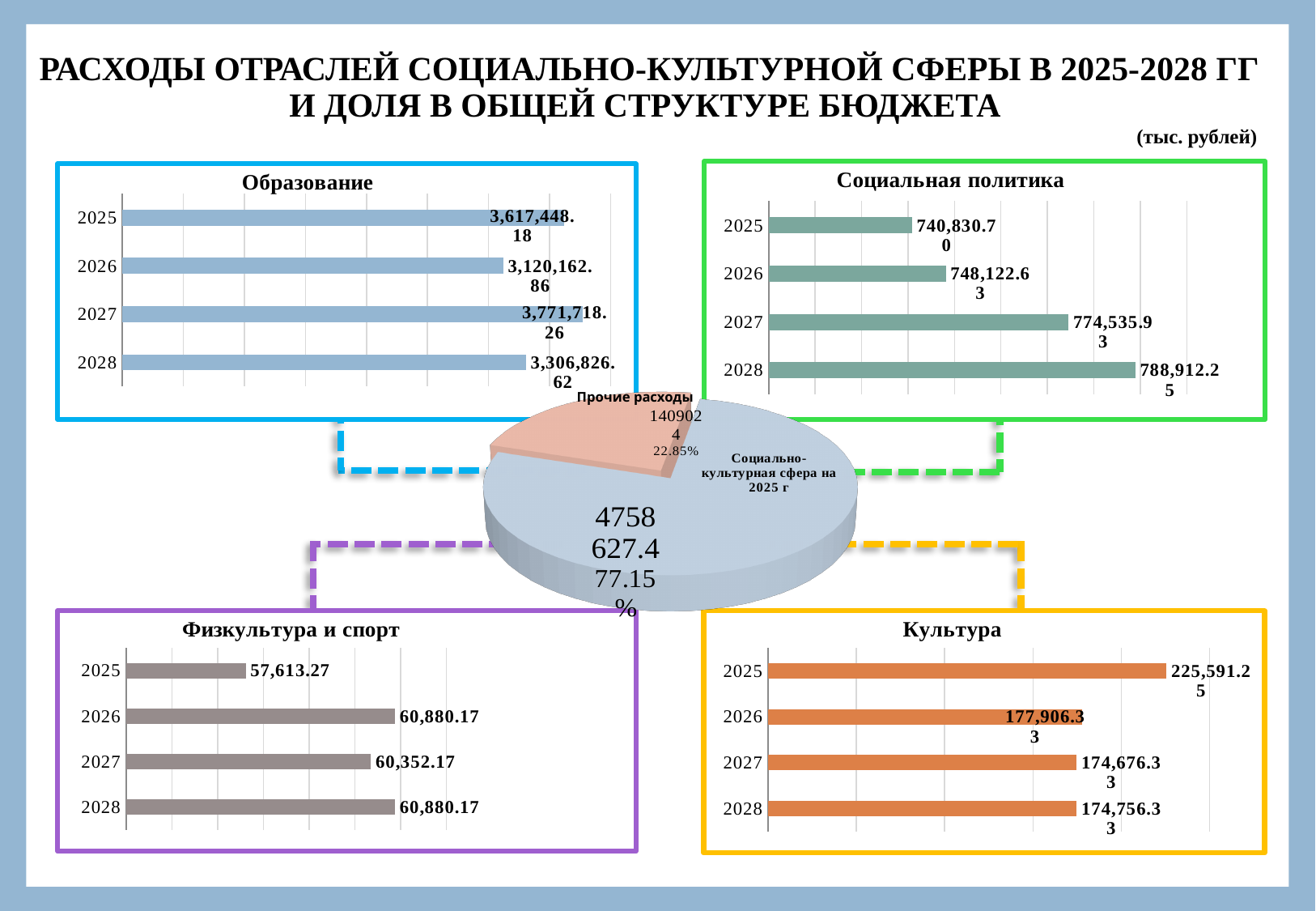
In the Физкультура и спорт chart, what is the value for 2025? 57,613.27 In the pie chart in the centre of the slide, what share does Прочие расходы have? 22.85% In the Физкультура и спорт chart, what is the difference between the 2026 and 2027 values? 528.00 In the Социальная политика chart, what is the value for 2028? 788,912.25 In the Образование chart, which year has the lowest value? 2026 In the pie chart in the centre of the slide, what share does Социально-культурная сфера на 2025 г have? 77.15% In the Культура chart, which is larger, the value for 2025 or the value for 2028? 2025 What kind of chart is the Образование chart? bar chart In the Социальная политика chart, do the values rise or fall from 2025 to 2028? rise In the Культура chart, which year has the highest value? 2025 In the Образование chart, what is the value for 2027? 3,771,718.26 In the Культура chart, what is the value for 2026? 177,906.33